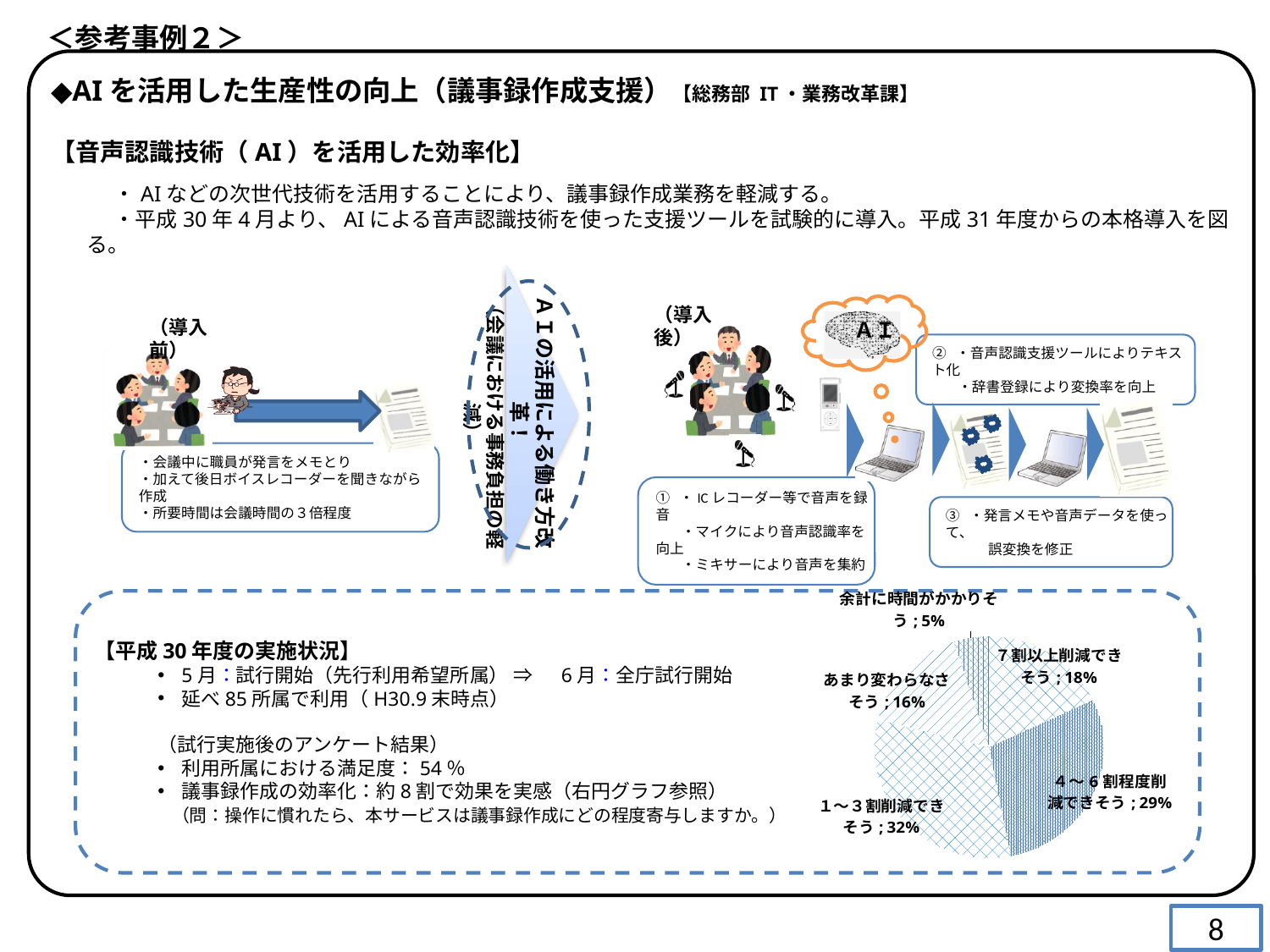
In the pie chart, what percentage is shown for 「7割以上削減できそう」? 18% In the pie chart, which is larger: 「4～6割程度削減できそう」 or 「あまり変わらなさそう」? 4～6割程度削減できそう Which slice of the pie chart has the largest share? 1～3割削減できそう In the pie chart, what is the difference in percentage points between 「1～3割削減できそう」 and 「7割以上削減できそう」? 14 In the pie chart, what is the combined share of 「7割以上削減できそう」 and 「4～6割程度削減できそう」? 47% In the pie chart, what percentage is shown for 「1～3割削減できそう」? 32% In the pie chart, what percentage is shown for 「余計に時間がかかりそう」? 5% In the pie chart, what percentage is shown for 「あまり変わらなさそう」? 16% What kind of chart is shown at the bottom right of the slide? Pie chart How many slices does the pie chart have? 5 Which slice of the pie chart has the smallest share? 余計に時間がかかりそう In the pie chart, what percentage is shown for 「4～6割程度削減できそう」? 29%